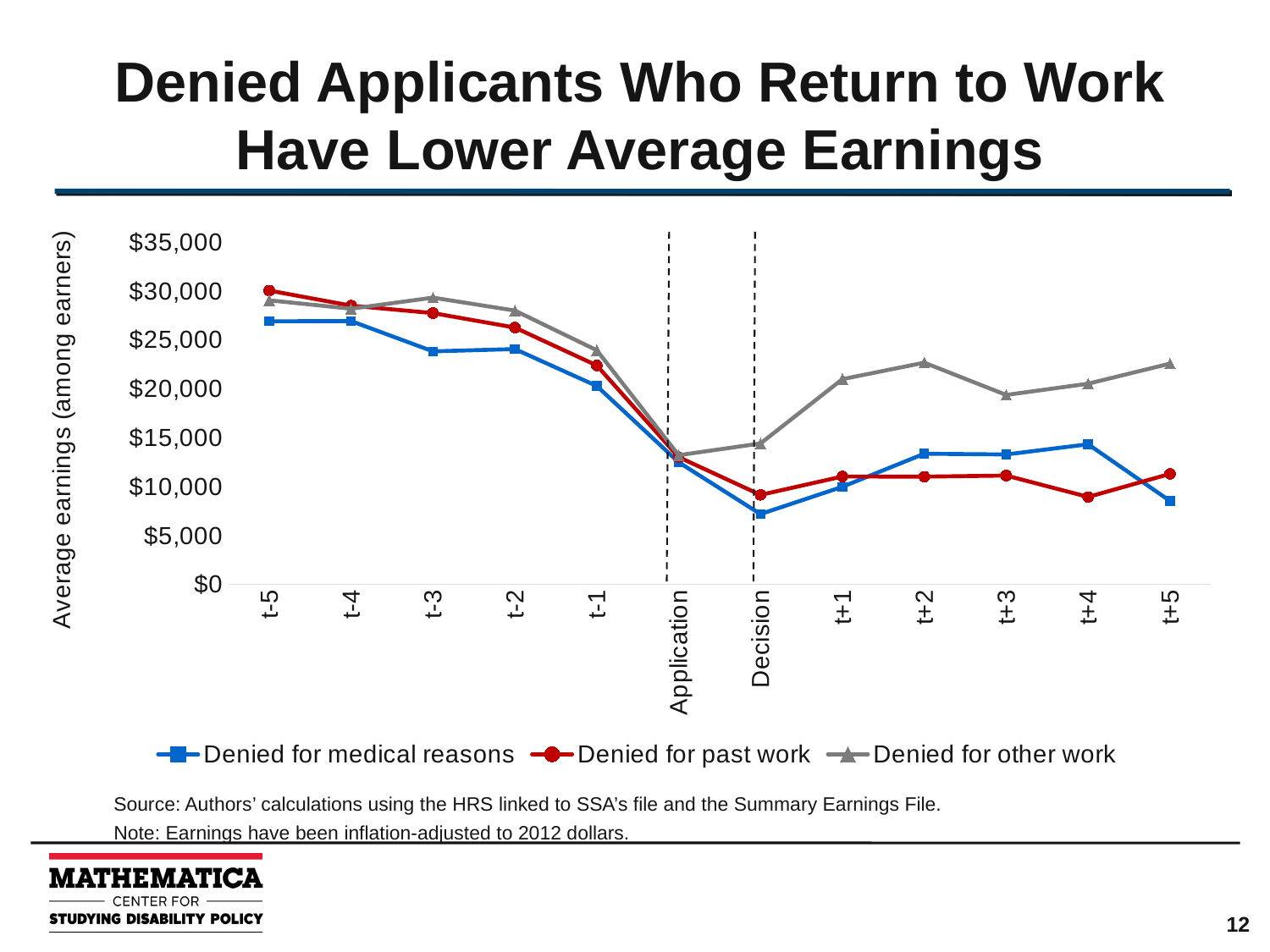
From t-5 to Application, does the Denied for past work series rise or fall? fall What is the title of the y axis? Average earnings (among earners) Is the value for Denied for other work at t+2 greater or less than $20,000? greater What kind of chart is shown on the slide? Line chart At which x-axis point does the Denied for medical reasons series reach its lowest value? Decision At t+1, which series has the higher value: Denied for other work or Denied for medical reasons? Denied for other work How many points are labelled along the x axis? 12 Is the value for Denied for medical reasons at Decision greater or less than $10,000? less How many series does the legend list? 3 At t+5, which series has the higher value: Denied for past work or Denied for medical reasons? Denied for past work Is the value for Denied for past work at t-5 greater or less than $25,000? greater At which x-axis point does the Denied for past work series reach its highest value? t-5